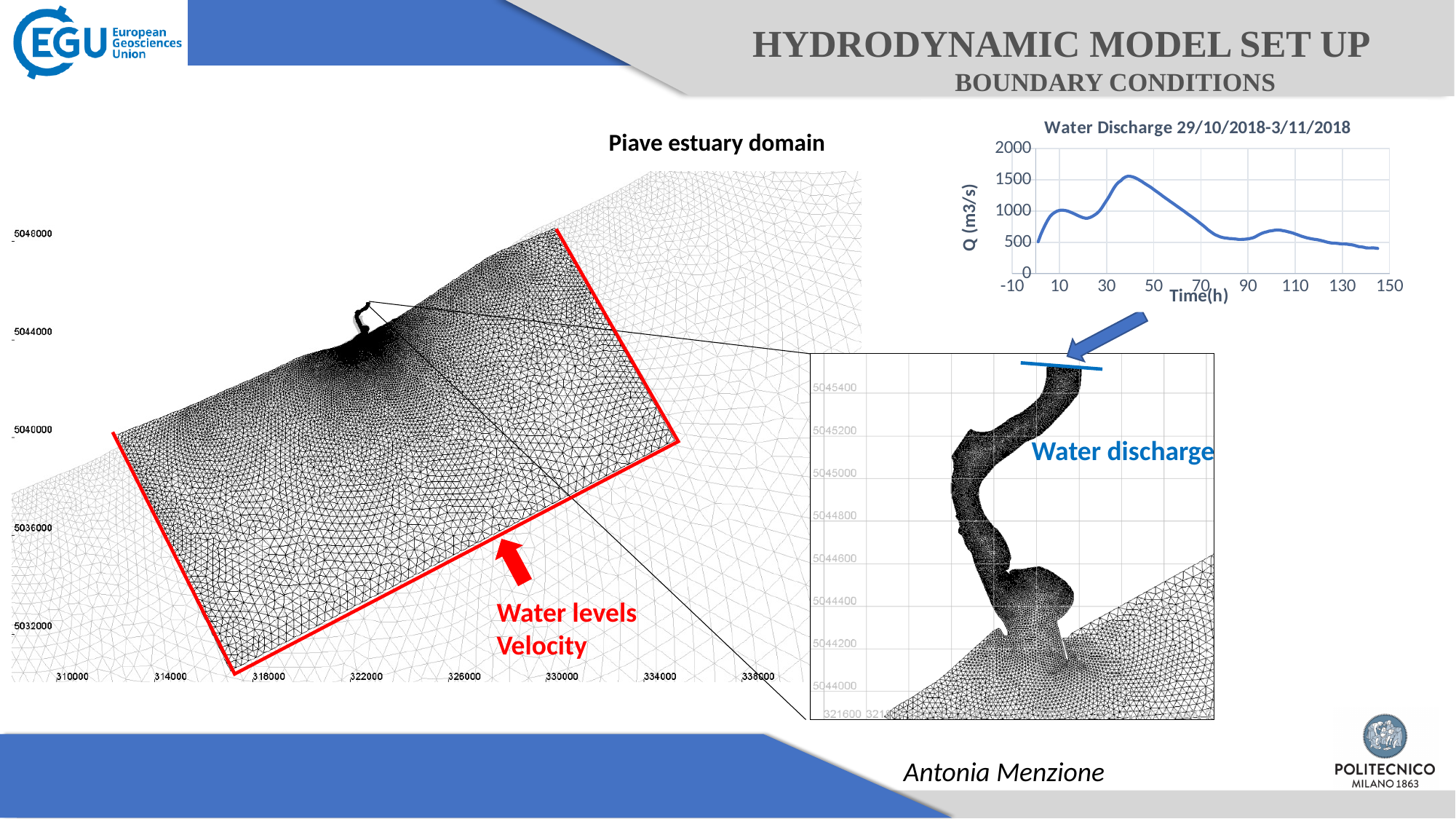
What kind of chart is the 'Water Discharge 29/10/2018-3/11/2018' chart? line chart What is the title of the chart in the top right of the slide? Water Discharge 29/10/2018-3/11/2018 On the Water Discharge chart, is the discharge at 30 h greater or less than 1000? greater On the Water Discharge chart, does the discharge rise or fall between 10 h and 30 h? rise What is the label of the y axis on the Water Discharge chart? Q (m3/s) On the Water Discharge chart, is the discharge at 30 h larger or smaller than the discharge at 130 h? larger On the Water Discharge chart, is the discharge at 90 h greater or less than 1000? less On the Water Discharge chart, is the peak discharge greater or less than 1000? greater How many lines are plotted on the Water Discharge chart? 1 On the Water Discharge chart, does the maximum discharge occur before or after 70 h? before On the Water Discharge chart, does the discharge rise or fall between 50 h and 70 h? fall